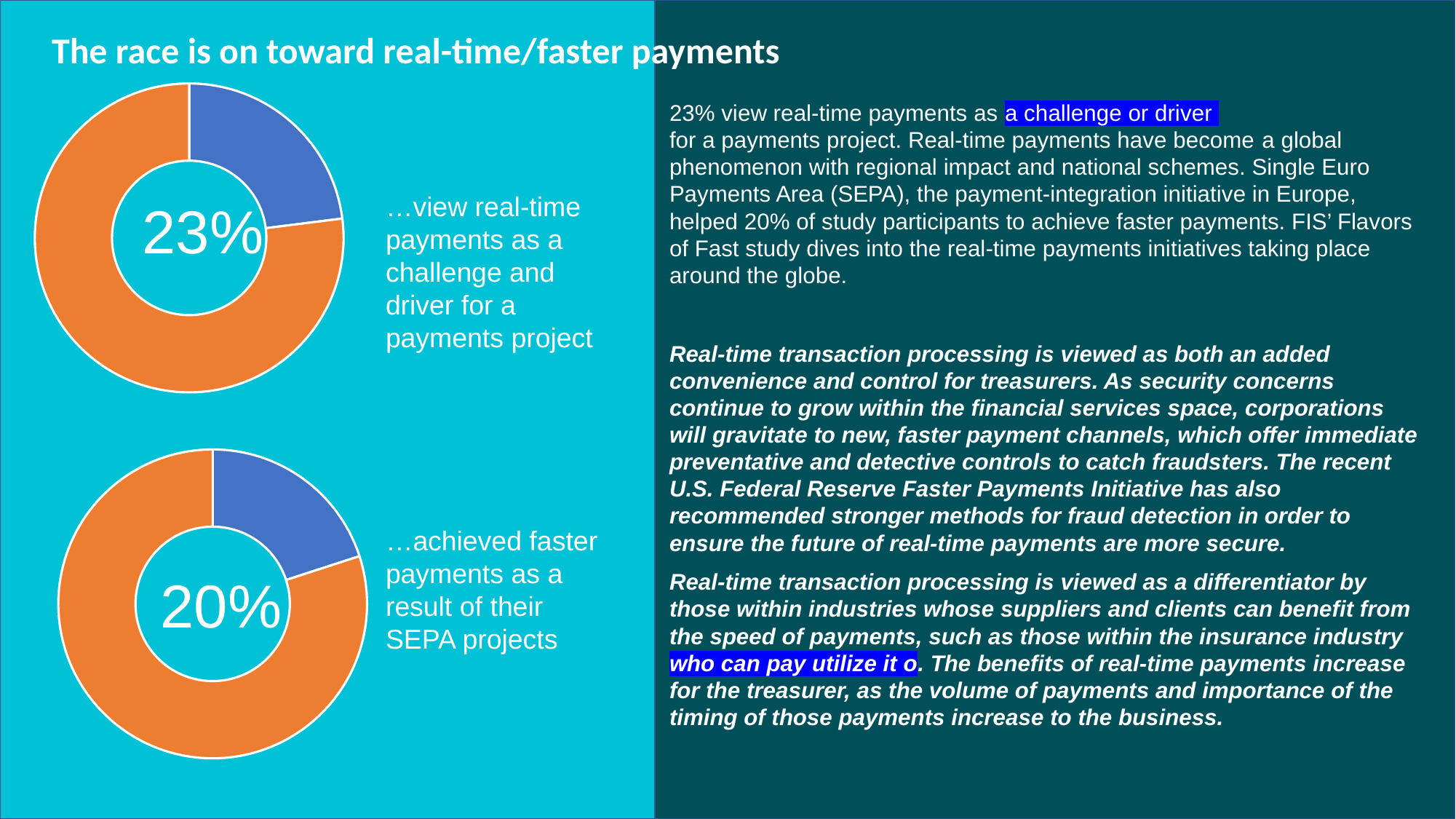
According to the bottom donut chart, what share of respondents achieved faster payments as a result of their SEPA projects? 20% How many slices does the top donut chart have? 2 According to the top donut chart, what share of respondents view real-time payments as a challenge and driver for a payments project? 23% What percentage is shown in the centre of the bottom donut chart? 20% In the top donut chart, what colour is the slice representing the 23% share? Blue Which is larger: the highlighted share in the top donut chart or the highlighted share in the bottom donut chart? The top donut chart (23%) How many slices does the bottom donut chart have? 2 What kind of chart is the top chart on the left of the slide? Donut (pie) chart What percentage is shown in the centre of the top donut chart? 23% What is the difference in percentage points between the value in the top donut chart and the value in the bottom donut chart? 3 percentage points How many donut charts are shown on the slide? 2 In the bottom donut chart, what colour is the larger slice? Orange